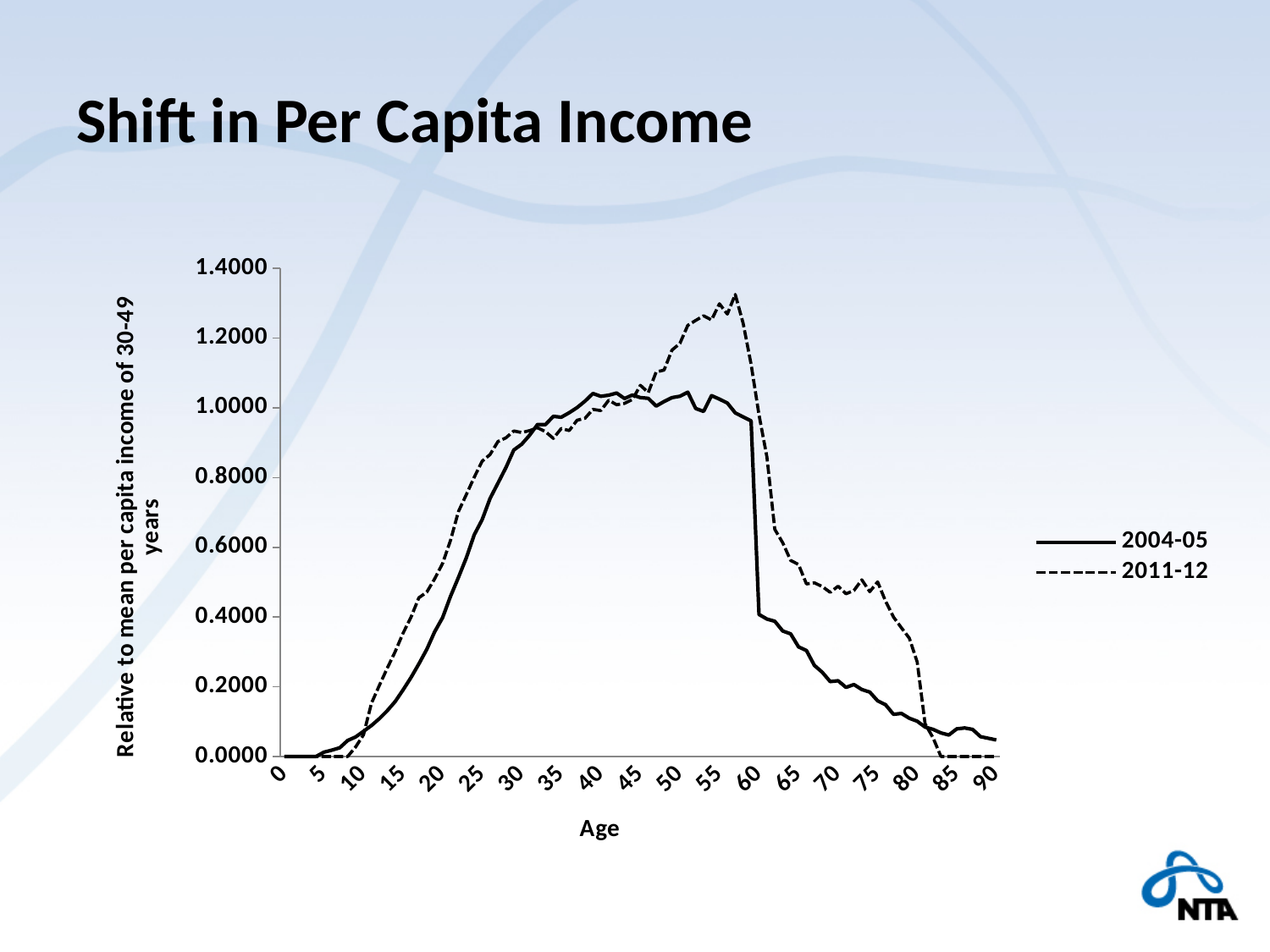
Is the value for the 2004-05 series at age 65 greater or less than 0.4000? less Is the value for the 2004-05 series at age 40 greater or less than 0.8000? greater What is the title of the x axis? Age Is the value for the 2011-12 series at age 55 greater or less than 1.2000? greater Does the 2004-05 series rise or fall between age 60 and age 90? fall How many series does the legend list? 2 What are the two series named in the legend? 2004-05 and 2011-12 What kind of chart is shown on the slide? line chart Which series reaches the highest peak value on the chart? 2011-12 At age 15, which series has the higher value, 2004-05 or 2011-12? 2011-12 At age 70, which series has the higher value, 2004-05 or 2011-12? 2011-12